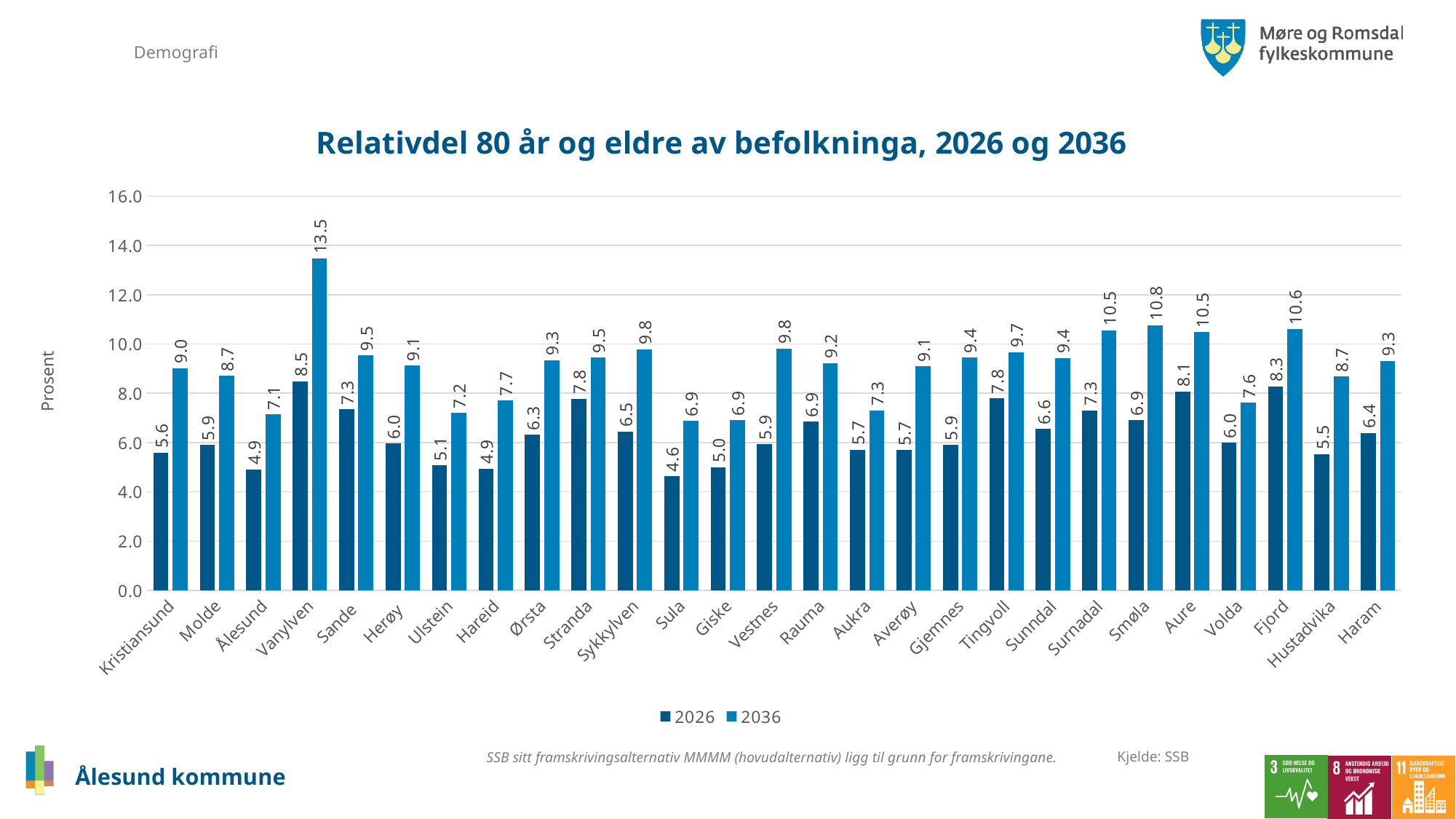
What is the 2026 value for Ålesund? 4.9 Which municipality has the highest 2036 value? Vanylven What is the difference between the 2036 and 2026 values for Ålesund? 2.2 What is the 2036 value for Vanylven? 13.5 How many series does the legend list? 2 How many municipalities are shown on the x axis? 27 What is the difference between the 2036 and 2026 values for Vanylven? 5.0 Which municipality has the lowest 2026 value? Sula What kind of chart is shown on the slide? Bar chart Which is larger: the 2026 value for Aure or the 2026 value for Volda? Aure What is the 2036 value for Smøla? 10.8 What is the 2026 value for Fjord? 8.3